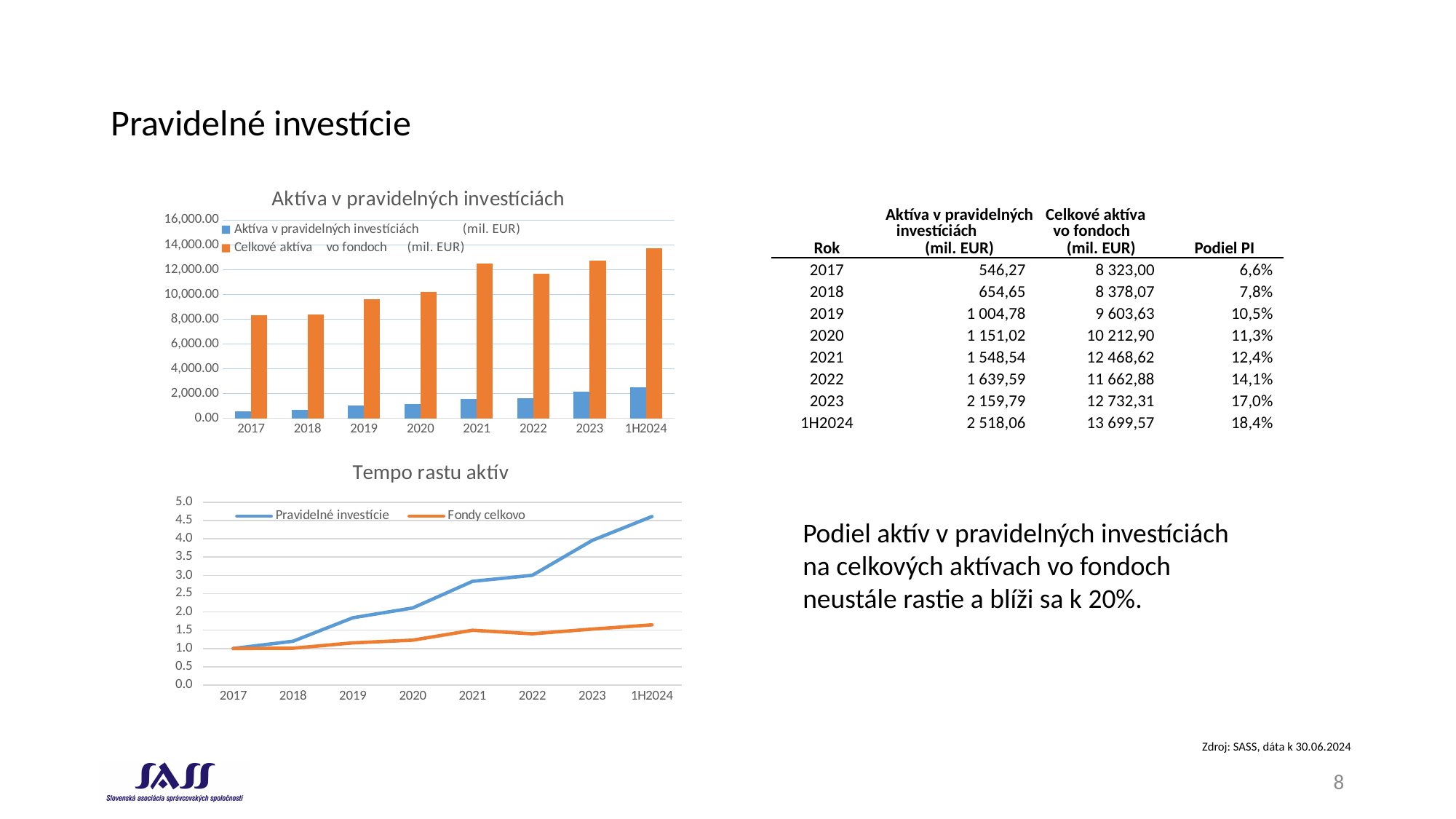
In the top chart "Aktíva v pravidelných investíciách", is the value for Celkové aktíva vo fondoch in 2021 greater or less than 12,000.00? greater In the bottom chart "Tempo rastu aktív", is the value for Fondy celkovo in 1H2024 greater or less than 2.0? less What kind of chart is the top chart titled "Aktíva v pravidelných investíciách"? bar chart In the bottom chart "Tempo rastu aktív", how many series does the legend list? 2 In the bottom chart "Tempo rastu aktív", do the values for Pravidelné investície rise or fall from 2017 to 1H2024? rise What kind of chart is the bottom chart titled "Tempo rastu aktív"? line chart In the top chart "Aktíva v pravidelných investíciách", how many categories are shown on the x axis? 8 In the top chart "Aktíva v pravidelných investíciách", which category has the highest value for Celkové aktíva vo fondoch? 1H2024 In the top chart "Aktíva v pravidelných investíciách", how many series does the legend list? 2 In the top chart "Aktíva v pravidelných investíciách", which is larger for Celkové aktíva vo fondoch: 2021 or 2022? 2021 In the top chart "Aktíva v pravidelných investíciách", is the value for Aktíva v pravidelných investíciách in 1H2024 greater or less than 2,000.00? greater In the top chart "Aktíva v pravidelných investíciách", which category has the lowest value for Aktíva v pravidelných investíciách? 2017